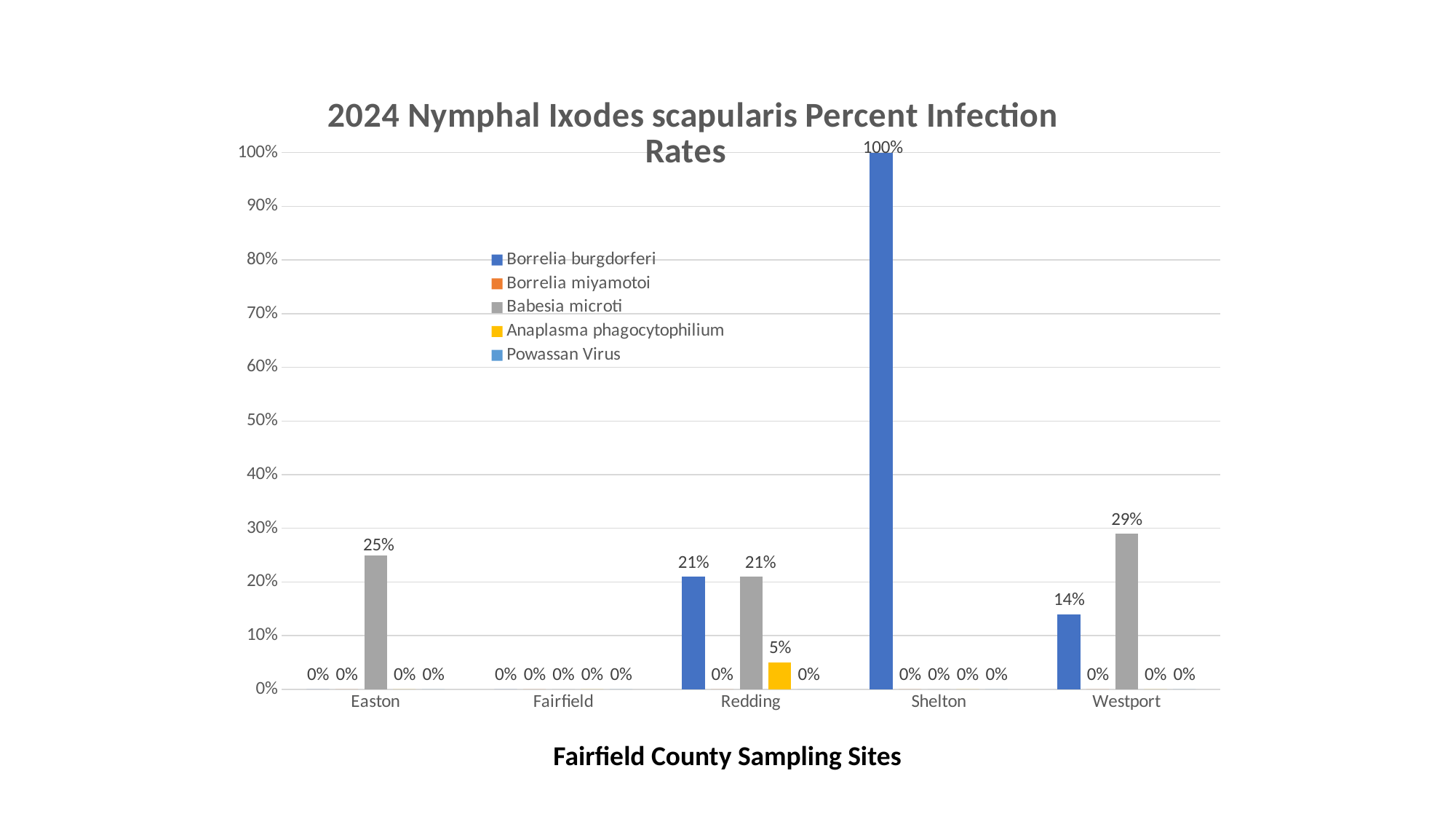
Which sampling site has the highest Borrelia burgdorferi infection rate? Shelton What is the x-axis title of the chart? Fairfield County Sampling Sites Which is larger: the Borrelia burgdorferi rate at Redding or at Westport? Redding What is the Anaplasma phagocytophilium infection rate at Redding? 5% What is the Babesia microti infection rate at Westport? 29% How many sampling sites are shown on the x axis? 5 What is the Borrelia burgdorferi infection rate at Shelton? 100% Which sampling site has the highest Babesia microti infection rate? Westport How many series does the legend list? 5 What is the Babesia microti infection rate at Easton? 25% What is the difference between the Babesia microti rate at Westport and at Easton? 4% What kind of chart is shown on the slide? Bar chart